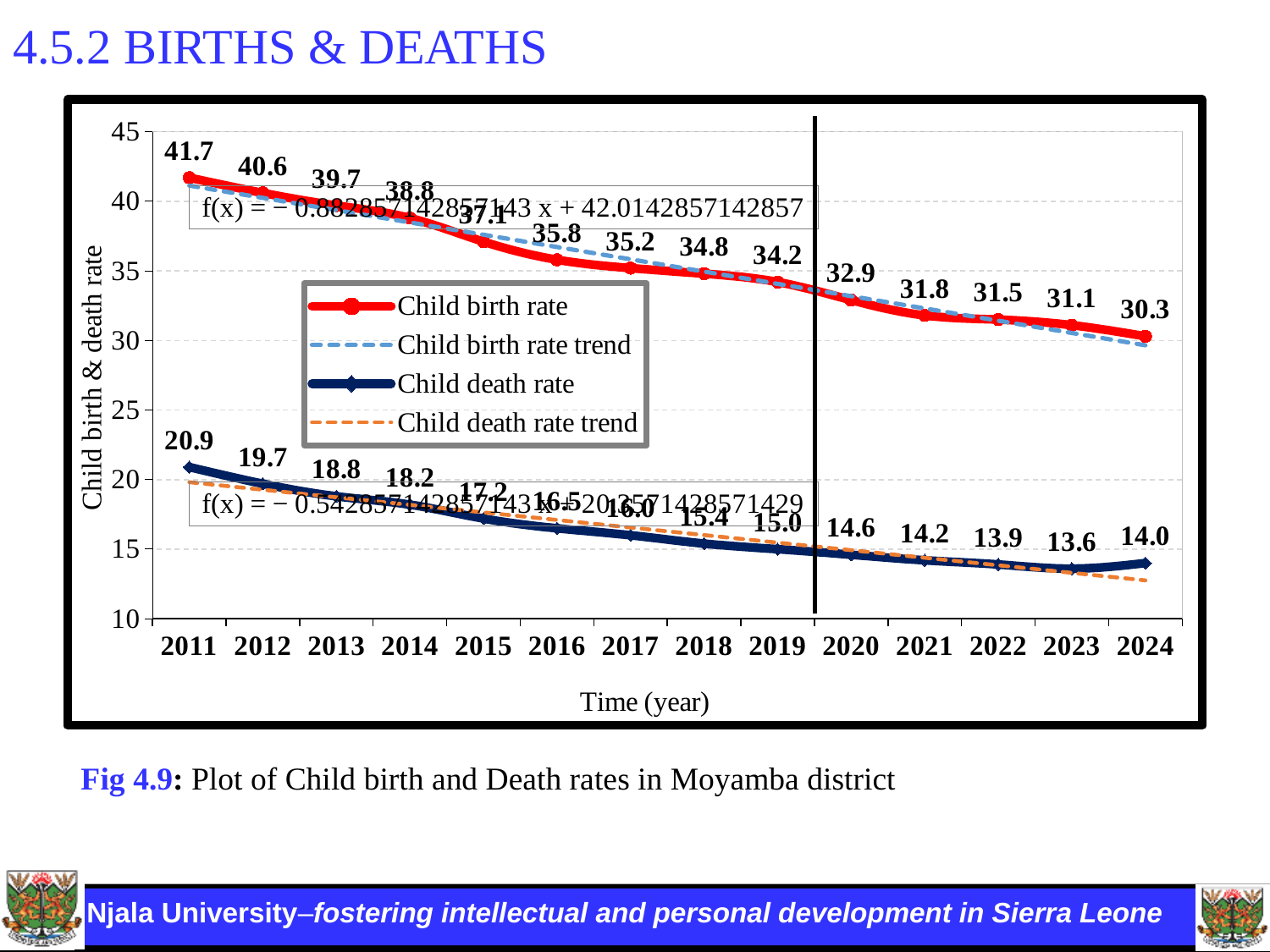
In which year is the child birth rate lowest? 2024 Which is larger, the child death rate in 2023 or in 2024? 2024 What is the child birth rate in 2011? 41.7 In which year is the child death rate highest? 2011 How many series does the legend list? 4 Is the child birth rate in 2016 greater or less than 35? greater What is the difference between the child birth rate in 2011 and in 2024? 11.4 How many years are plotted on the x axis? 14 What is the child birth rate in 2020? 32.9 What is the child death rate in 2024? 14.0 What is the child death rate in 2018? 15.4 What kind of chart is shown? Line chart